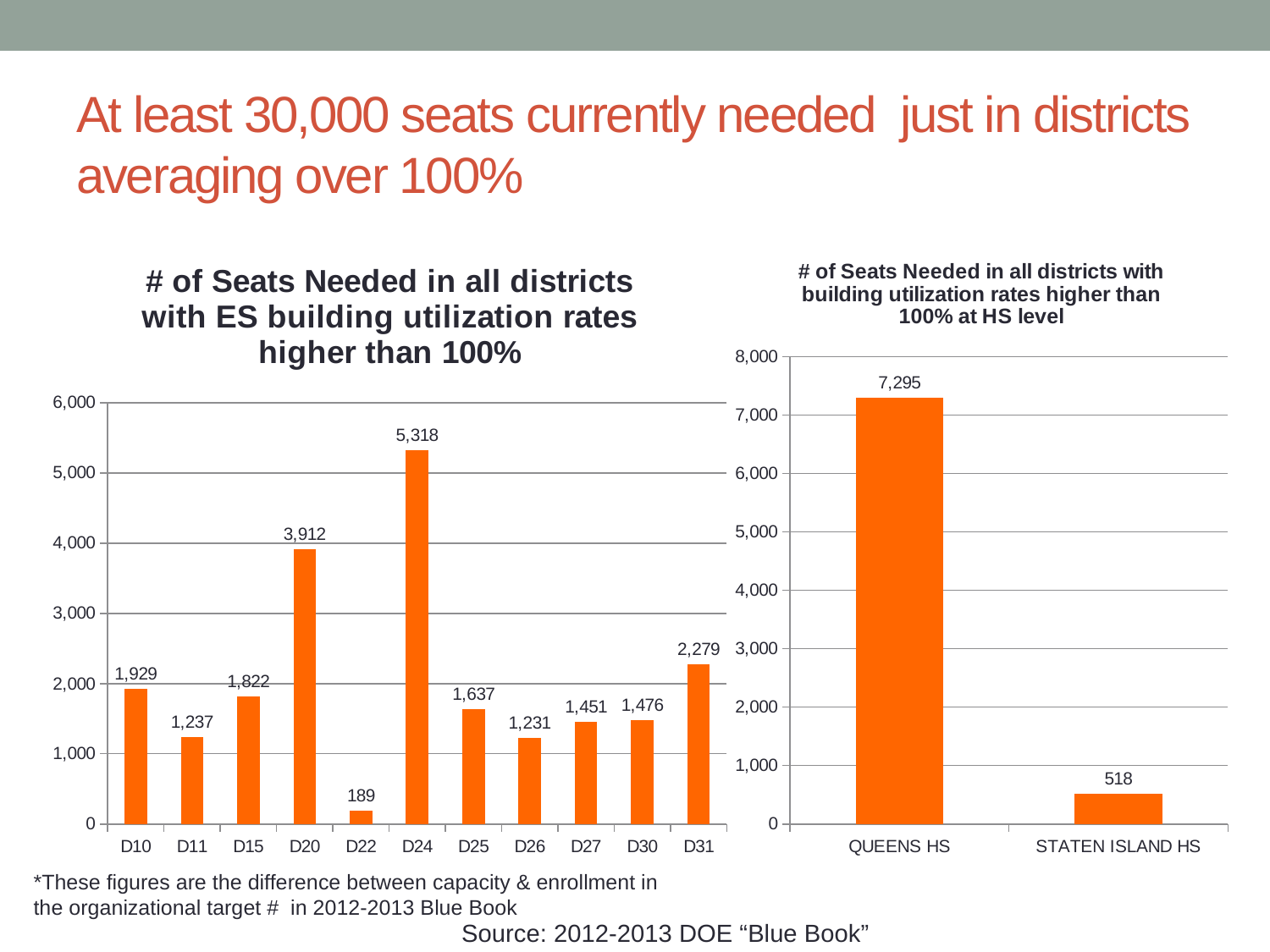
In the left chart (ES building utilization rates higher than 100%), how many districts are shown? 11 In the left chart (ES building utilization rates higher than 100%), which district has the highest number of seats needed? D24 In the left chart (ES building utilization rates higher than 100%), which district has the lowest number of seats needed? D22 What type of chart is the right chart (HS level)? Bar chart In the left chart (ES building utilization rates higher than 100%), which district needs more seats, D10 or D15? D10 In the left chart (ES building utilization rates higher than 100%), how many seats are needed in D22? 189 In the right chart (HS level), what is the difference in seats needed between QUEENS HS and STATEN ISLAND HS? 6,777 In the right chart (HS level), how many seats are needed in STATEN ISLAND HS? 518 In the left chart (ES building utilization rates higher than 100%), how many seats are needed in D24? 5,318 In the left chart (ES building utilization rates higher than 100%), what is the difference between the seats needed in D30 and D27? 25 In the right chart (HS level), how many seats are needed in QUEENS HS? 7,295 In the left chart (ES building utilization rates higher than 100%), what is the difference between the seats needed in D20 and D31? 1,633